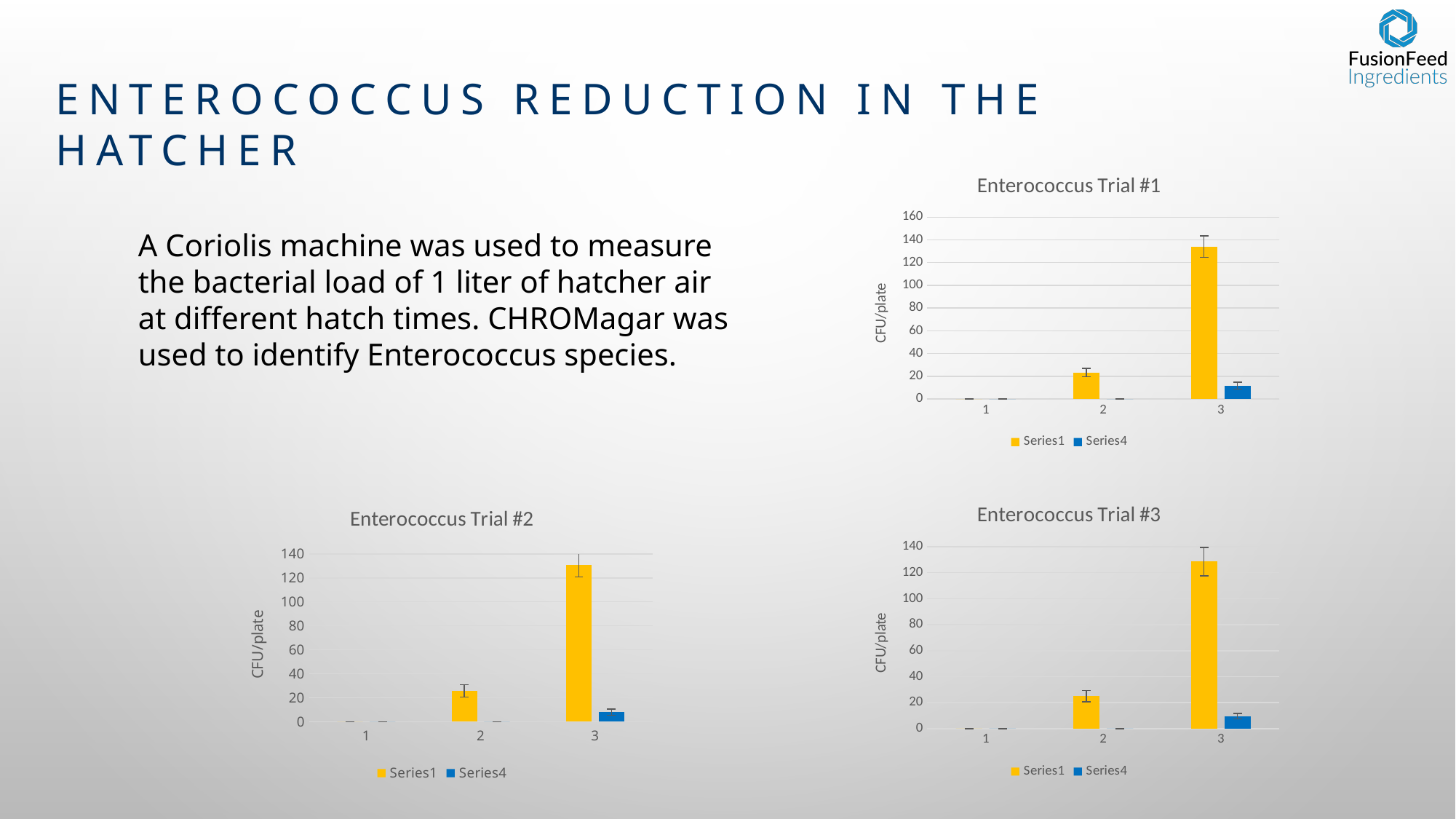
What is the y-axis label on the Enterococcus Trial #1 chart? CFU/plate How many series does the legend of the Enterococcus Trial #1 chart list? 2 What kind of chart is the Enterococcus Trial #2 chart? bar chart In the Enterococcus Trial #2 chart, is the Series1 value for category 3 greater or less than 120? greater In the Enterococcus Trial #1 chart, is the Series1 value for category 2 greater or less than 40? less In the Enterococcus Trial #1 chart, is the Series1 value for category 3 greater or less than 120? greater In the Enterococcus Trial #1 chart, which category has the highest Series1 value? 3 In the Enterococcus Trial #3 chart, do the Series1 values rise or fall from category 1 to category 3? rise How many categories are shown on the x axis of the Enterococcus Trial #2 chart? 3 In the Enterococcus Trial #2 chart, at category 3, which is larger: Series1 or Series4? Series1